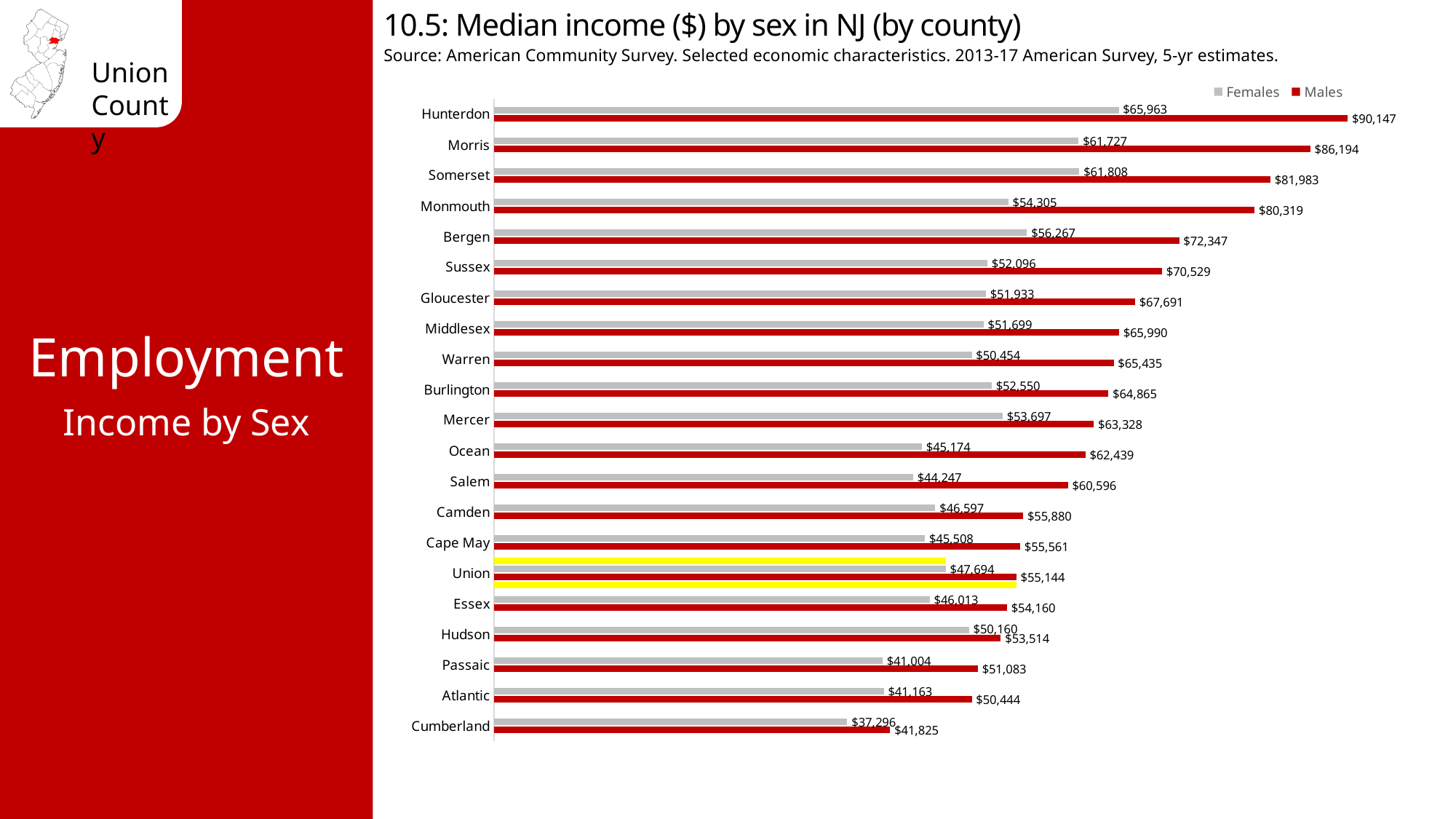
What is the median income for males in Hunterdon County? $90,147 Which county has the lowest median income for females? Cumberland What is the median income for females in Union County? $47,694 What is the difference between male and female median income in Union County? $7,450 What kind of chart is shown on the slide? Bar chart How many counties are shown on the chart? 21 Which is larger: the female median income in Bergen County or in Monmouth County? Bergen County How many series does the legend list? 2 Which county has the highest median income for males? Hunterdon What is the median income for females in Cumberland County? $37,296 What is the difference between male and female median income in Hunterdon County? $24,184 What is the median income for males in Union County? $55,144